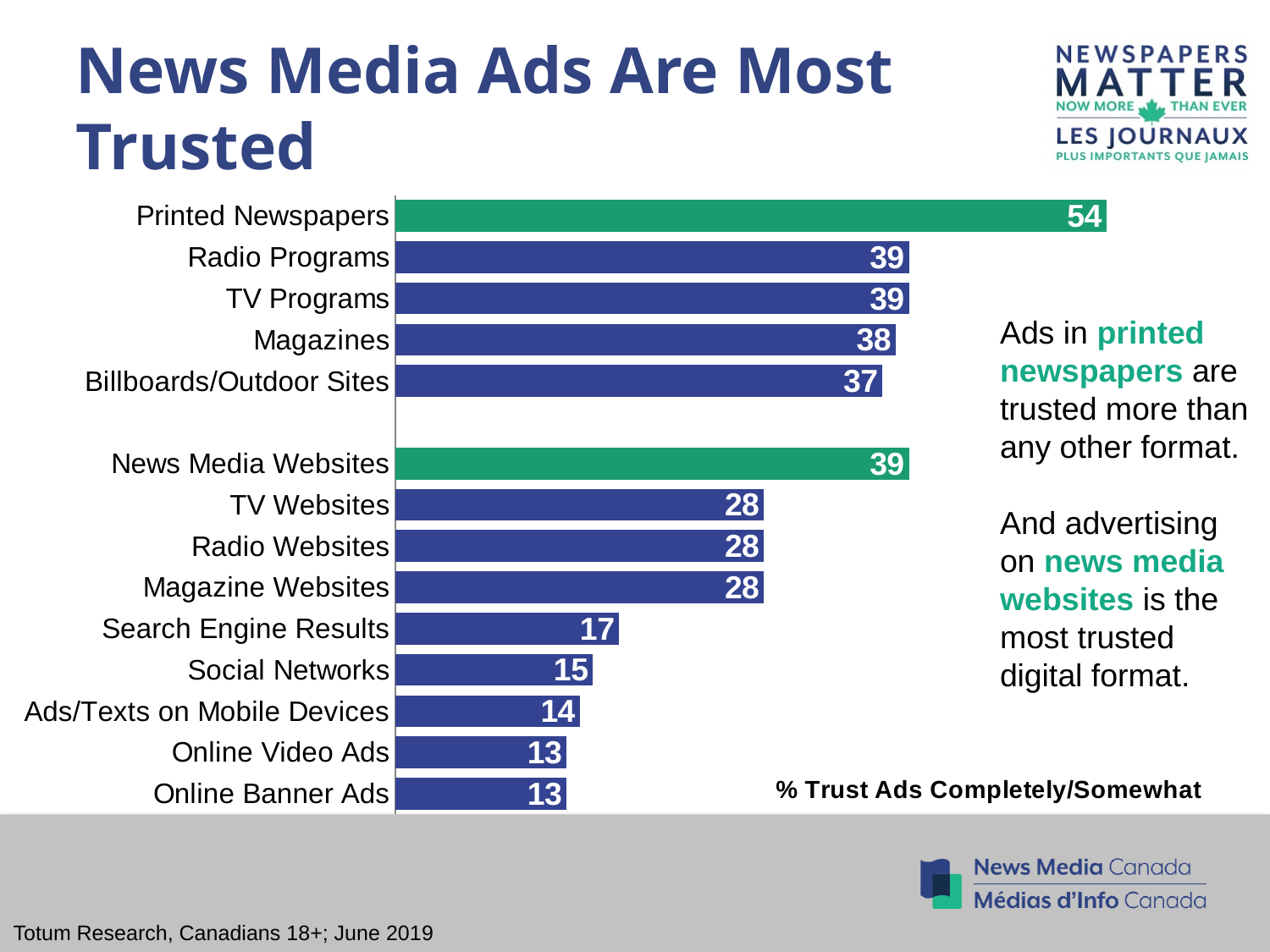
What is the value for Printed Newspapers? 54 Which is larger, the value for Magazines or the value for TV Websites? Magazines How many categories are shown in the chart? 14 Which category has the highest value? Printed Newspapers Which is larger, the value for Search Engine Results or the value for Social Networks? Search Engine Results What is the difference between the values for Printed Newspapers and News Media Websites? 15 What is the difference between the values for Social Networks and Ads/Texts on Mobile Devices? 1 What kind of chart is shown on the slide? Bar chart What is the value for Search Engine Results? 17 What is the value for News Media Websites? 39 What is the value for Billboards/Outdoor Sites? 37 Which two bars are coloured green rather than blue? Printed Newspapers and News Media Websites